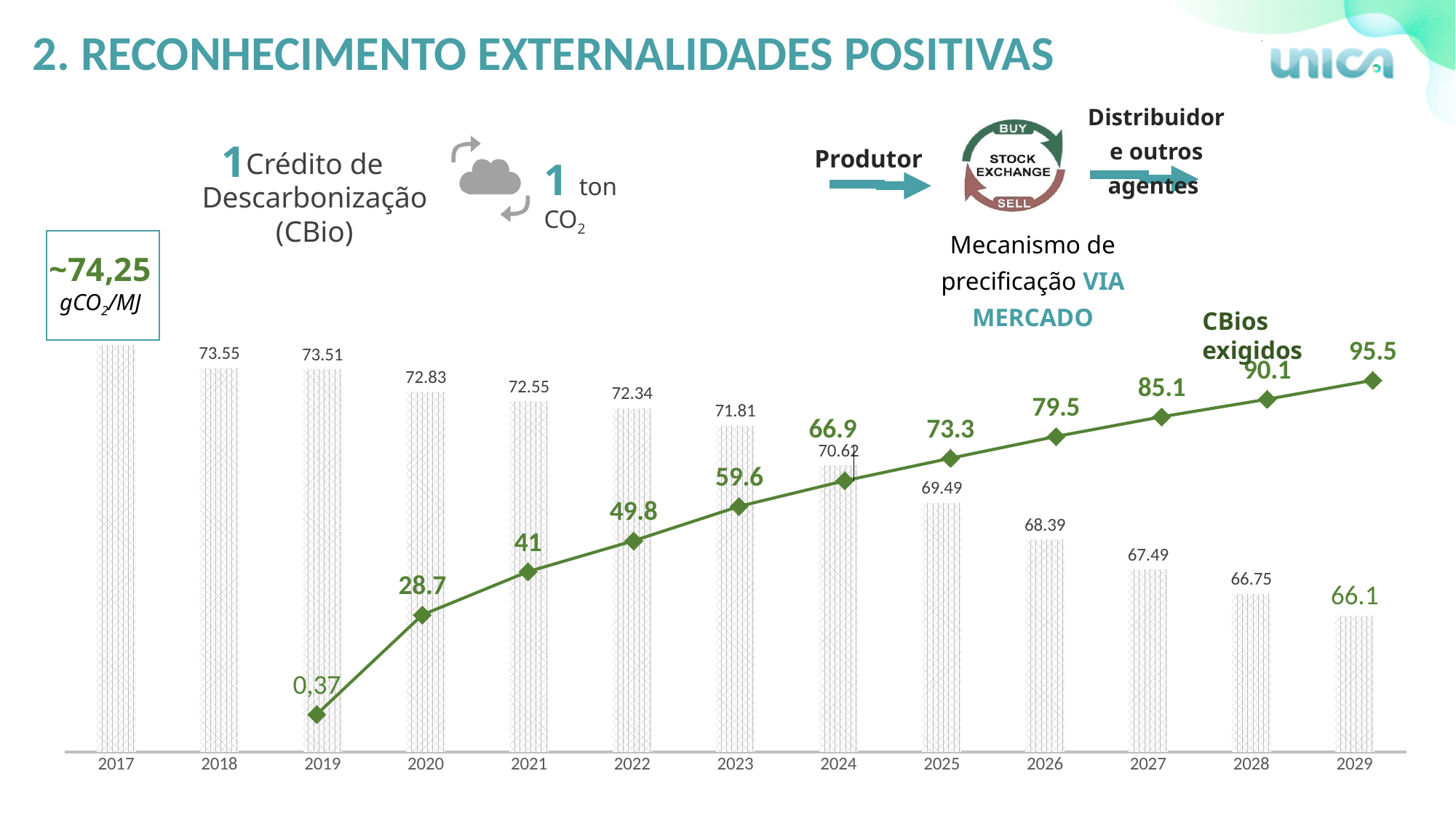
Do the CBios exigidos line values rise or fall from 2019 to 2029? rise Do the bar values rise or fall from 2018 to 2029? fall Which year has the lowest value on the CBios exigidos line? 2019 What is the CBios exigidos line value for 2021? 41 How many years are shown on the x axis? 13 Which year has the highest value on the CBios exigidos line? 2029 What is the value of the bar for 2024? 70.62 What is the difference between the bar values for 2018 and 2028? 6.80 What is the CBios exigidos line value for 2029? 95.5 Which is larger, the bar value for 2020 or the bar value for 2026? 2020 What is the value of the bar for 2018? 73.55 What is the difference between the CBios exigidos values for 2025 and 2024? 6.4